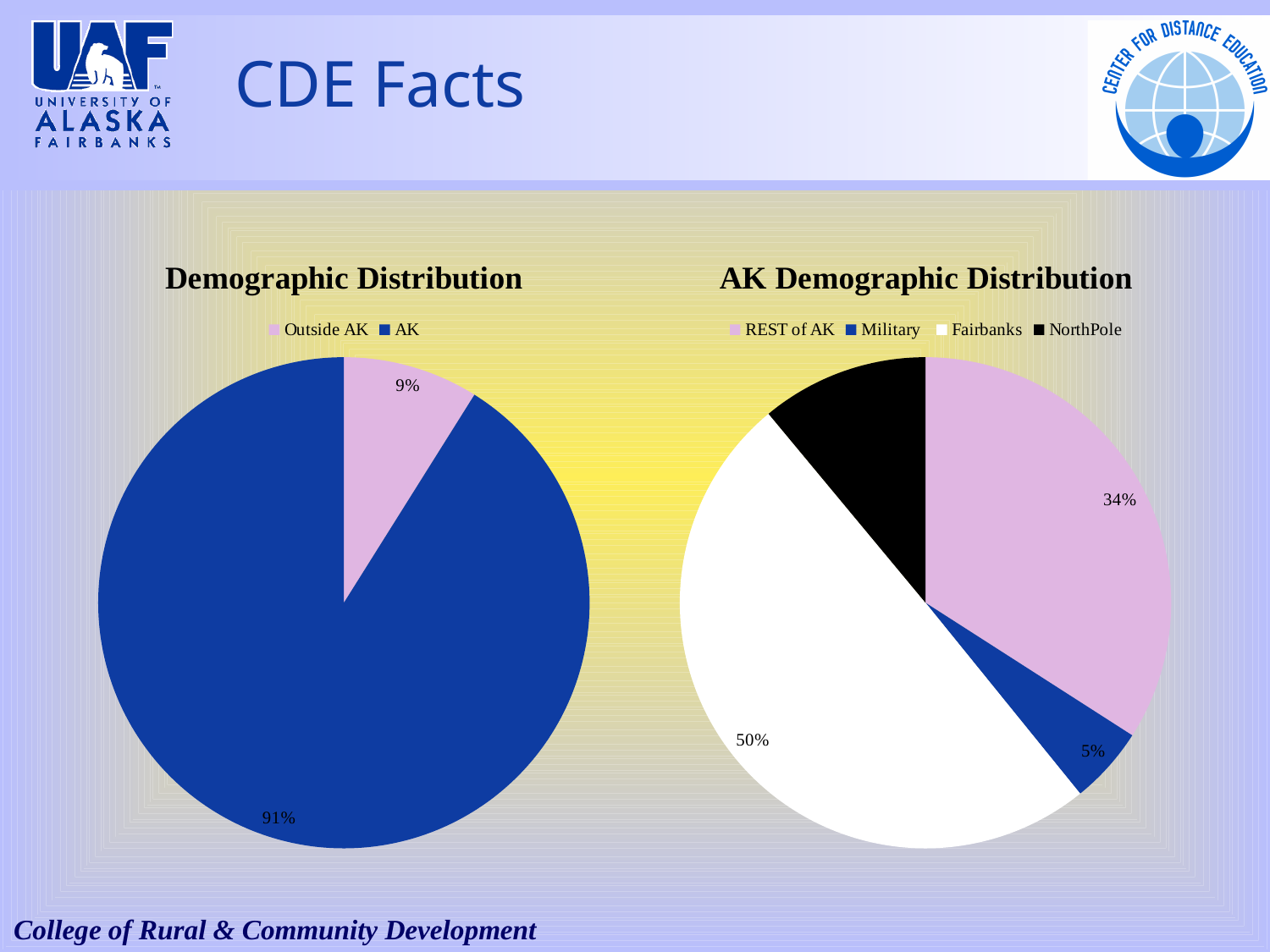
How many categories does the legend of the AK Demographic Distribution chart list? 4 In the AK Demographic Distribution chart, which is larger, REST of AK or Military? REST of AK What type of chart is the Demographic Distribution chart? Pie chart In the AK Demographic Distribution chart, what percentage is labelled for REST of AK? 34% In the AK Demographic Distribution chart, what percentage is labelled for Military? 5% In the Demographic Distribution chart, what is the difference in percentage points between AK and Outside AK? 82 In the AK Demographic Distribution chart, what percentage is labelled for Fairbanks? 50% In the Demographic Distribution chart, what percentage is labelled for Outside AK? 9% In the Demographic Distribution chart, what percentage is labelled for AK? 91% In the AK Demographic Distribution chart, what colour is the NorthPole slice? Black In the AK Demographic Distribution chart, which category has the smallest slice? Military In the AK Demographic Distribution chart, which category has the largest slice? Fairbanks